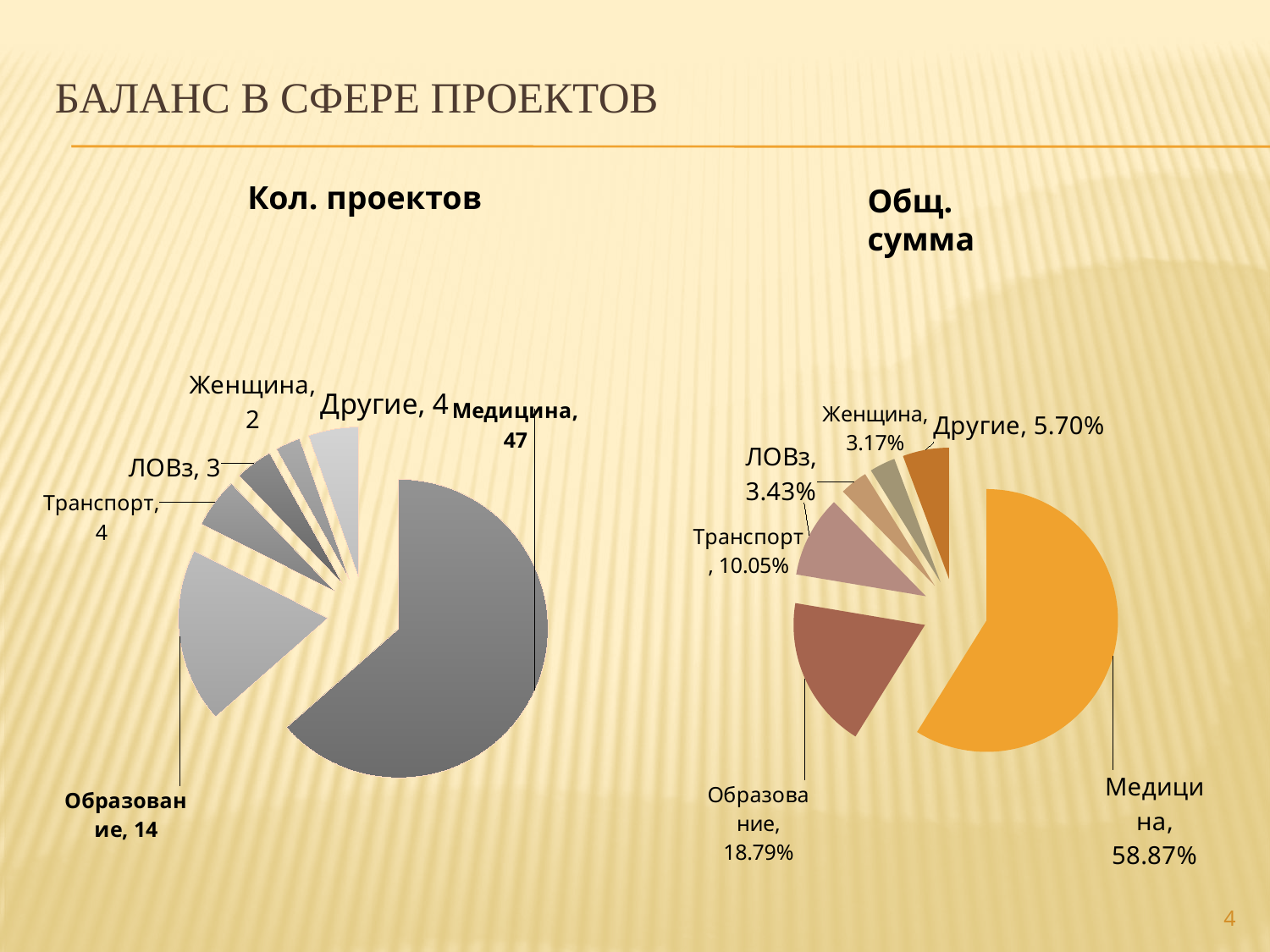
In the chart titled "Кол. проектов", what is the difference between the values for Медицина and Образование? 33 What type of chart is the chart titled "Общ. сумма"? Pie chart What is the title of the chart on the left side of the slide? Кол. проектов In the chart titled "Кол. проектов", how many projects are in the Медицина category? 47 In the chart titled "Общ. сумма", what is the value for Транспорт? 10.05% In the chart titled "Общ. сумма", which category has the smallest share? Женщина In the chart titled "Кол. проектов", which category has the largest number of projects? Медицина In the chart titled "Кол. проектов", which category has the smallest number of projects? Женщина In the chart titled "Общ. сумма", which is larger: Другие or ЛОВз? Другие In the chart titled "Кол. проектов", how many categories (slices) are shown? 6 In the chart titled "Общ. сумма", what share does Медицина have? 58.87% In the chart titled "Кол. проектов", what is the value for Образование? 14